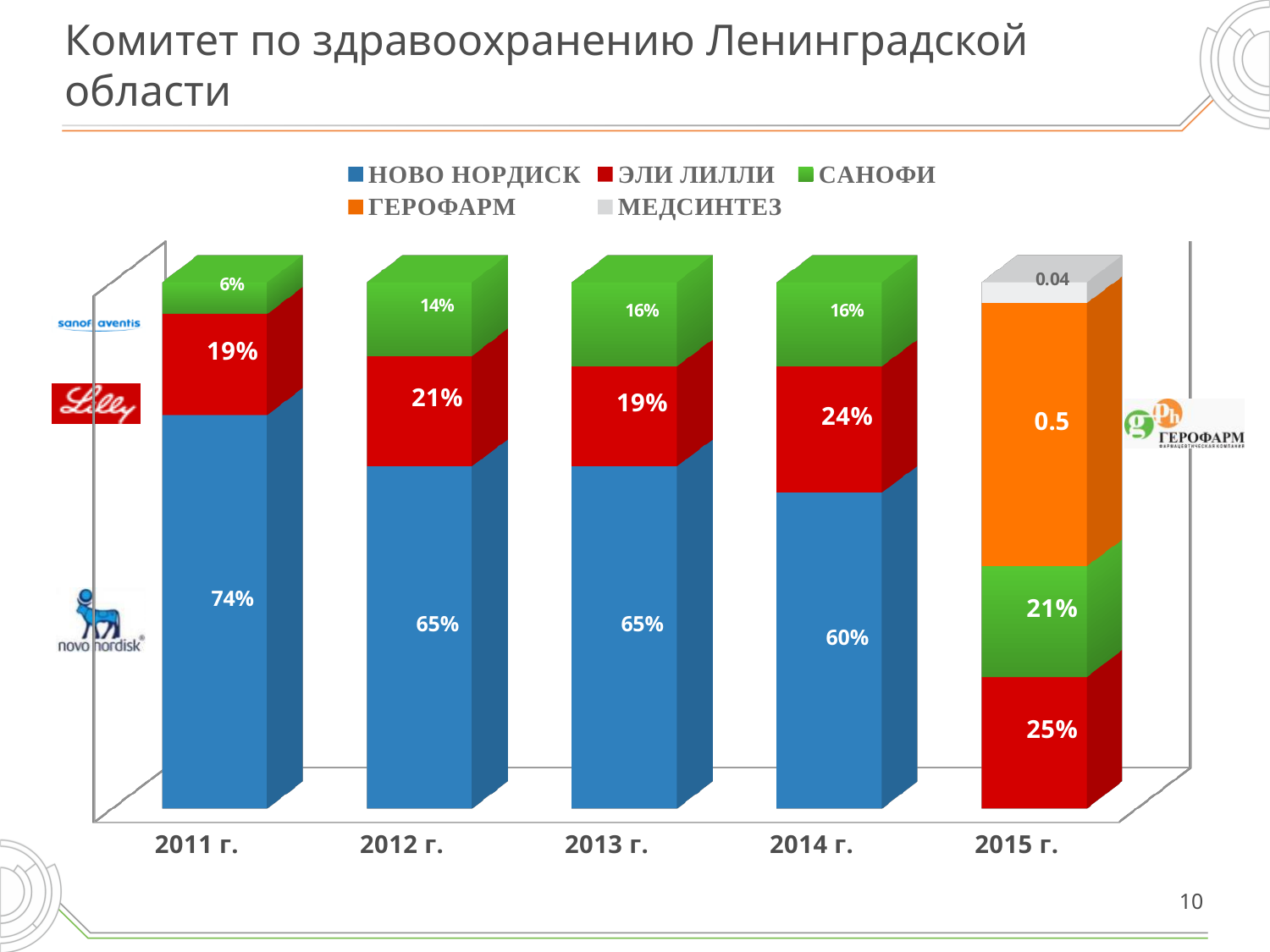
In which year is the value for САНОФИ the lowest? 2011 г. What kind of chart is shown on the slide? Stacked bar chart What is the value for НОВО НОРДИСК in 2011 г.? 74% What is the value for ГЕРОФАРМ in 2015 г.? 0.5 In which year is the value for НОВО НОРДИСК the highest? 2011 г. Which is larger: the ЭЛИ ЛИЛЛИ value in 2012 г. or in 2013 г.? 2012 г. What is the value for ЭЛИ ЛИЛЛИ in 2014 г.? 24% How many years are shown on the x axis? 5 How many series does the legend list? 5 What is the difference between the НОВО НОРДИСК values in 2011 г. and 2014 г.? 14 percentage points What is the value for МЕДСИНТЕЗ in 2015 г.? 0.04 What is the value for САНОФИ in 2012 г.? 14%